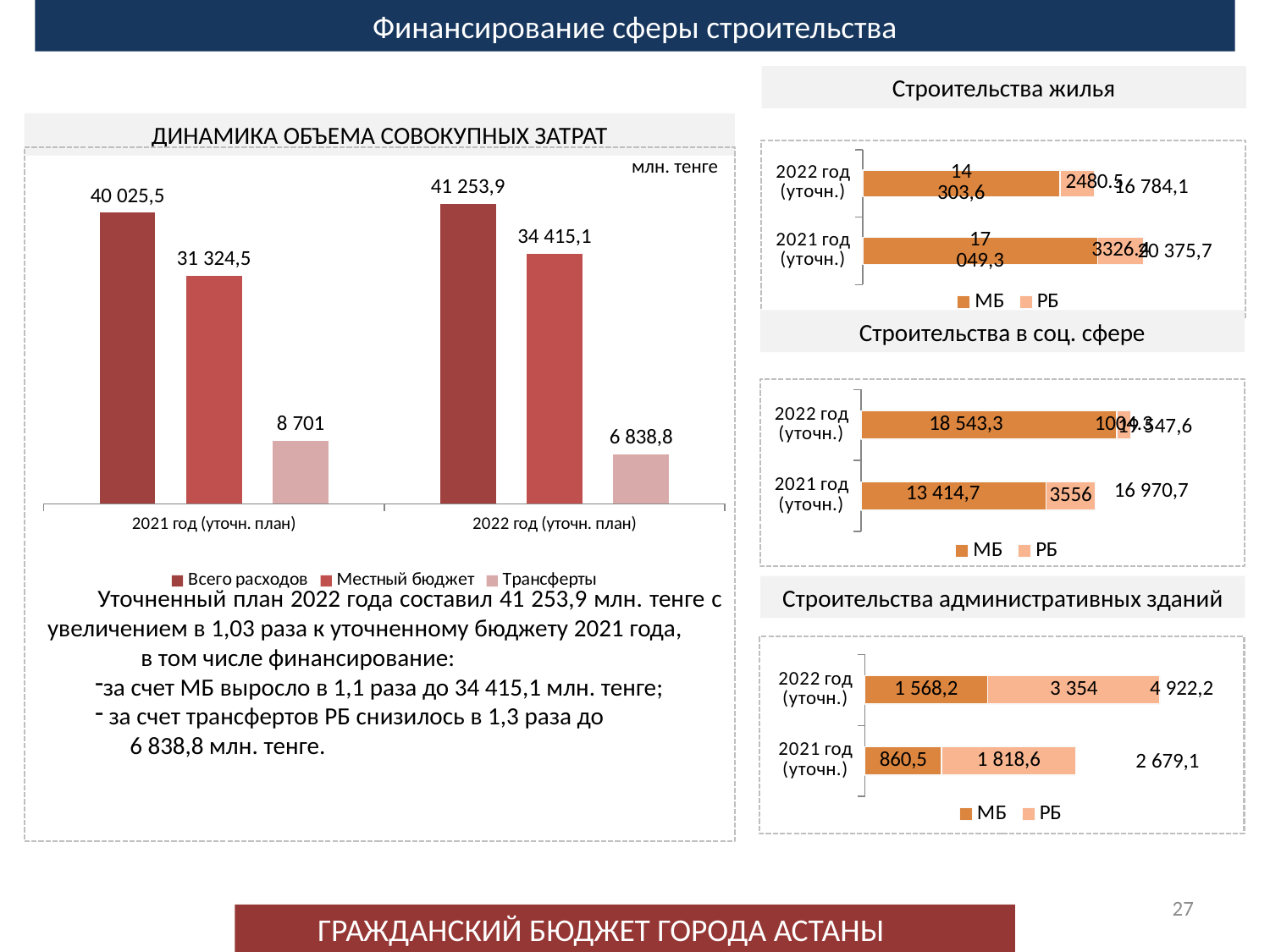
In the chart 'Строительства административных зданий', what is the РБ value for 2022 год (уточн.)? 3 354 In the chart 'Строительства административных зданий', what is the difference between the МБ values for 2022 год (уточн.) and 2021 год (уточн.)? 707,7 In the chart 'Строительства жилья', what is the МБ value for 2021 год (уточн.)? 17 049,3 In the chart 'ДИНАМИКА ОБЪЕМА СОВОКУПНЫХ ЗАТРАТ', which year has the larger 'Трансферты' value? 2021 год (уточн. план) What type of chart is 'ДИНАМИКА ОБЪЕМА СОВОКУПНЫХ ЗАТРАТ'? bar chart In the chart 'ДИНАМИКА ОБЪЕМА СОВОКУПНЫХ ЗАТРАТ', what unit is shown in the top right corner? млн. тенге In the chart 'Строительства в соц. сфере', what is the total of the stacked bar for 2021 год (уточн.)? 16 970,7 In the chart 'ДИНАМИКА ОБЪЕМА СОВОКУПНЫХ ЗАТРАТ', what is the value of 'Трансферты' for 2021 год (уточн. план)? 8 701 How many series does the legend of the chart 'ДИНАМИКА ОБЪЕМА СОВОКУПНЫХ ЗАТРАТ' list? 3 In the chart 'ДИНАМИКА ОБЪЕМА СОВОКУПНЫХ ЗАТРАТ', what is the difference between 'Местный бюджет' in 2022 год (уточн. план) and in 2021 год (уточн. план)? 3 090,6 In the chart 'Строительства в соц. сфере', what is the РБ value for 2021 год (уточн.)? 3556 In the chart 'ДИНАМИКА ОБЪЕМА СОВОКУПНЫХ ЗАТРАТ', what is the value of 'Всего расходов' for 2022 год (уточн. план)? 41 253,9